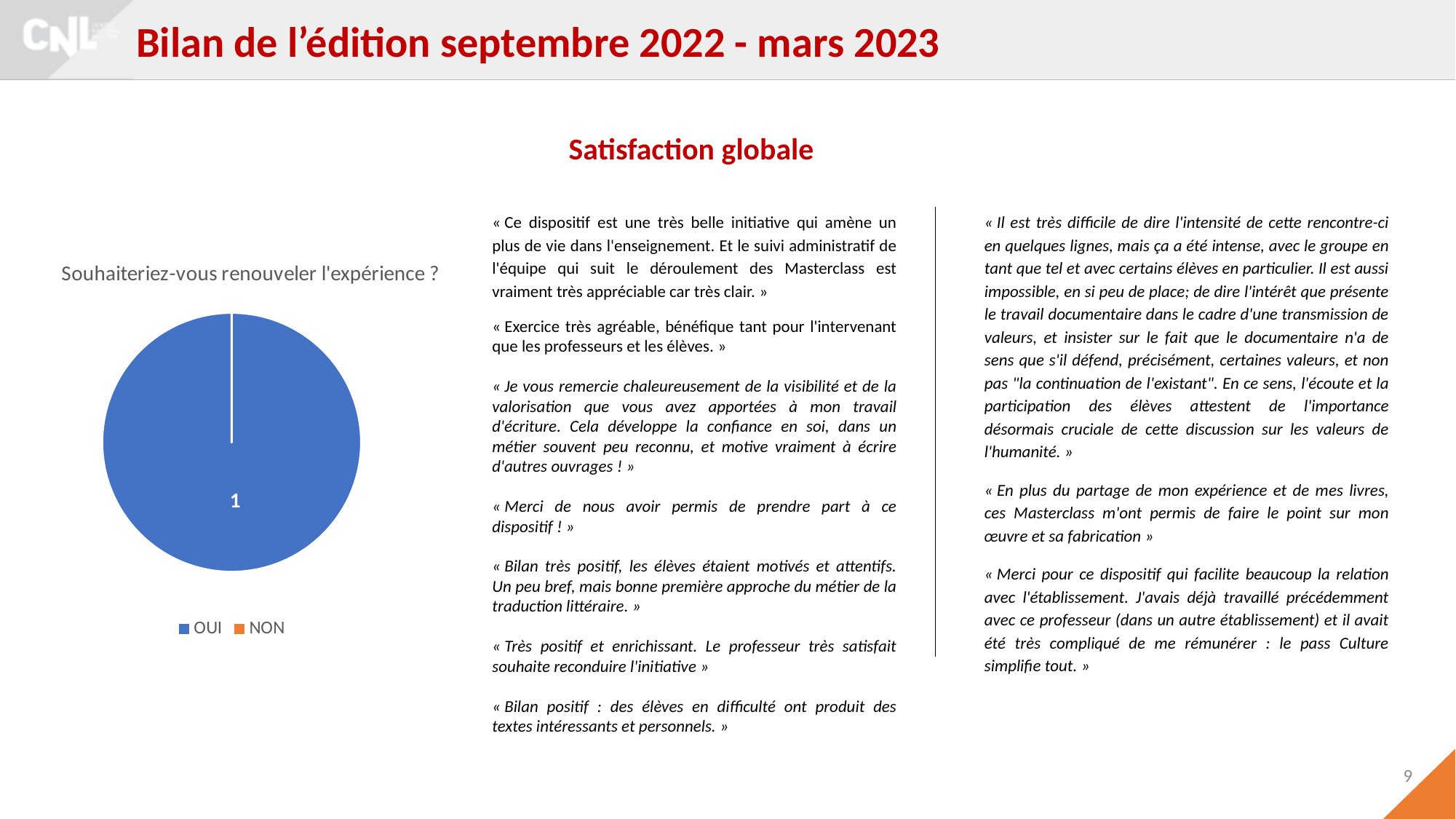
What data label is printed on the OUI slice of the pie chart? 1 What kind of chart is shown on the slide? pie chart What is the title of the pie chart? Souhaiteriez-vous renouveler l'expérience ? Which category has the smallest share of the pie chart? NON Which colour represents OUI in the pie chart? blue Which category takes the largest share of the pie chart? OUI How many entries does the legend of the pie chart list? 2 Which of the two categories, OUI or NON, has the larger share of the pie chart? OUI